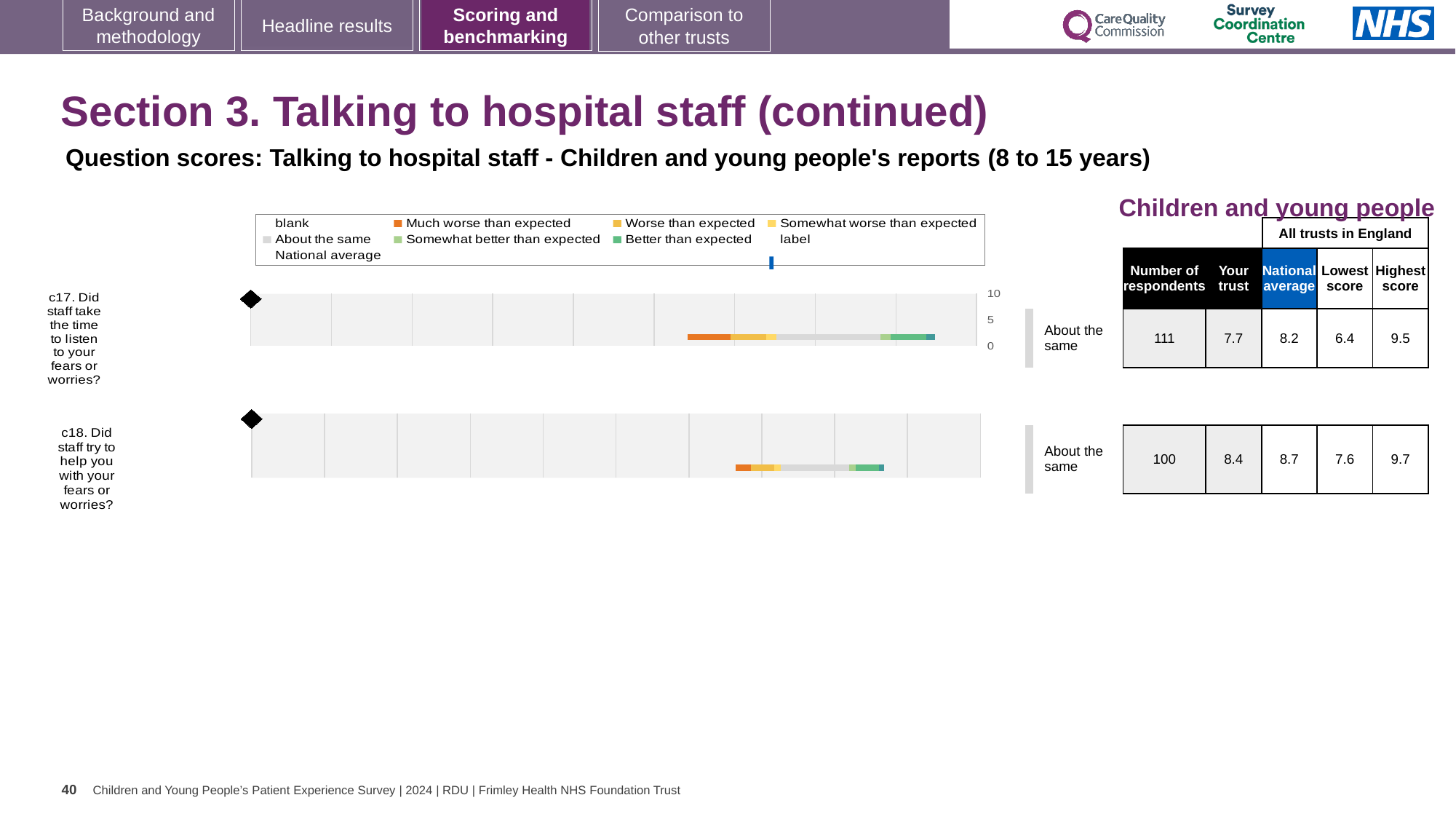
Is the 'Your trust' score for c17 greater or less than 5? greater What kind of chart is used to show the question scores for c17 and c18? bar chart How many respondents answered c17? 111 For c18, what is the highest score among all trusts in England? 9.7 For c18 (Did staff try to help you with your fears or worries?), what is the 'Your trust' score? 8.4 What is the difference between the highest and lowest scores for c18? 2.1 How many survey questions are plotted on the slide? 2 What benchmark category is shown for c18? About the same For c17 (Did staff take the time to listen to your fears or worries?), what is the 'Your trust' score? 7.7 For c17, what is the national average score? 8.2 What is the difference between the national average and the 'Your trust' score for c17? 0.5 Which question has the higher 'Your trust' score, c17 or c18? c18